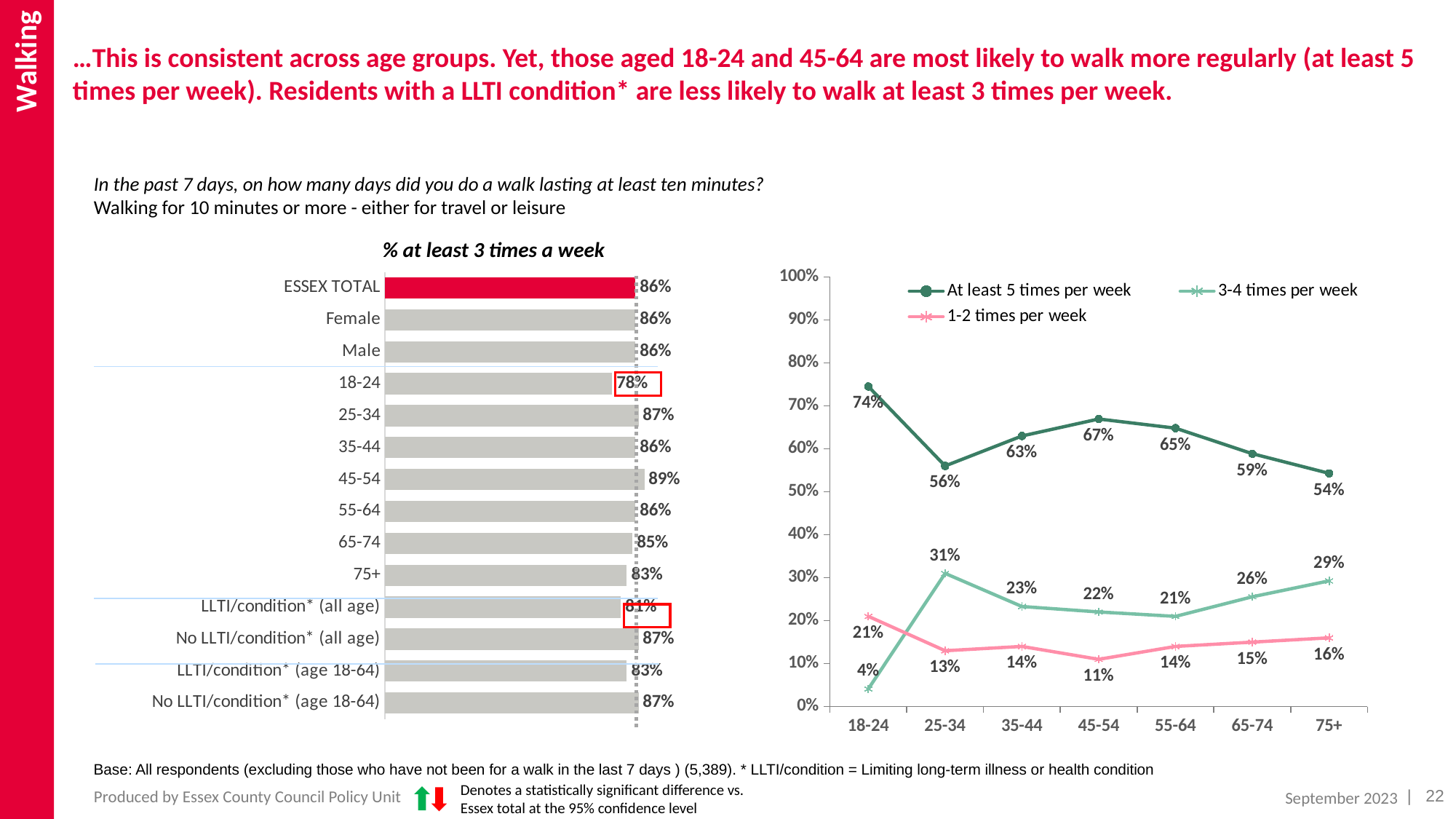
In the '% at least 3 times a week' bar chart, what is the difference between No LLTI/condition* (all age) and LLTI/condition* (all age)? 6 percentage points In the line chart on the right, how many series does the legend list? 3 In the '% at least 3 times a week' bar chart, which category has the highest value? 45-54 In the '% at least 3 times a week' bar chart, which category has the lowest value? 18-24 In the line chart on the right, which is larger at age 65-74: '3-4 times per week' or '1-2 times per week'? 3-4 times per week In the line chart on the right, is the value for 'At least 5 times per week' at 75+ greater or less than 50%? greater In the '% at least 3 times a week' bar chart, how many categories are shown? 14 In the line chart on the right, which age group has the lowest value for '1-2 times per week'? 45-54 In the '% at least 3 times a week' bar chart, what is the value for ESSEX TOTAL? 86% In the line chart on the right, what is the value for 'At least 5 times per week' at age 18-24? 74% In the line chart on the right, what is the value for '3-4 times per week' at age 25-34? 31% What kind of chart is the chart on the left of the slide? Bar chart